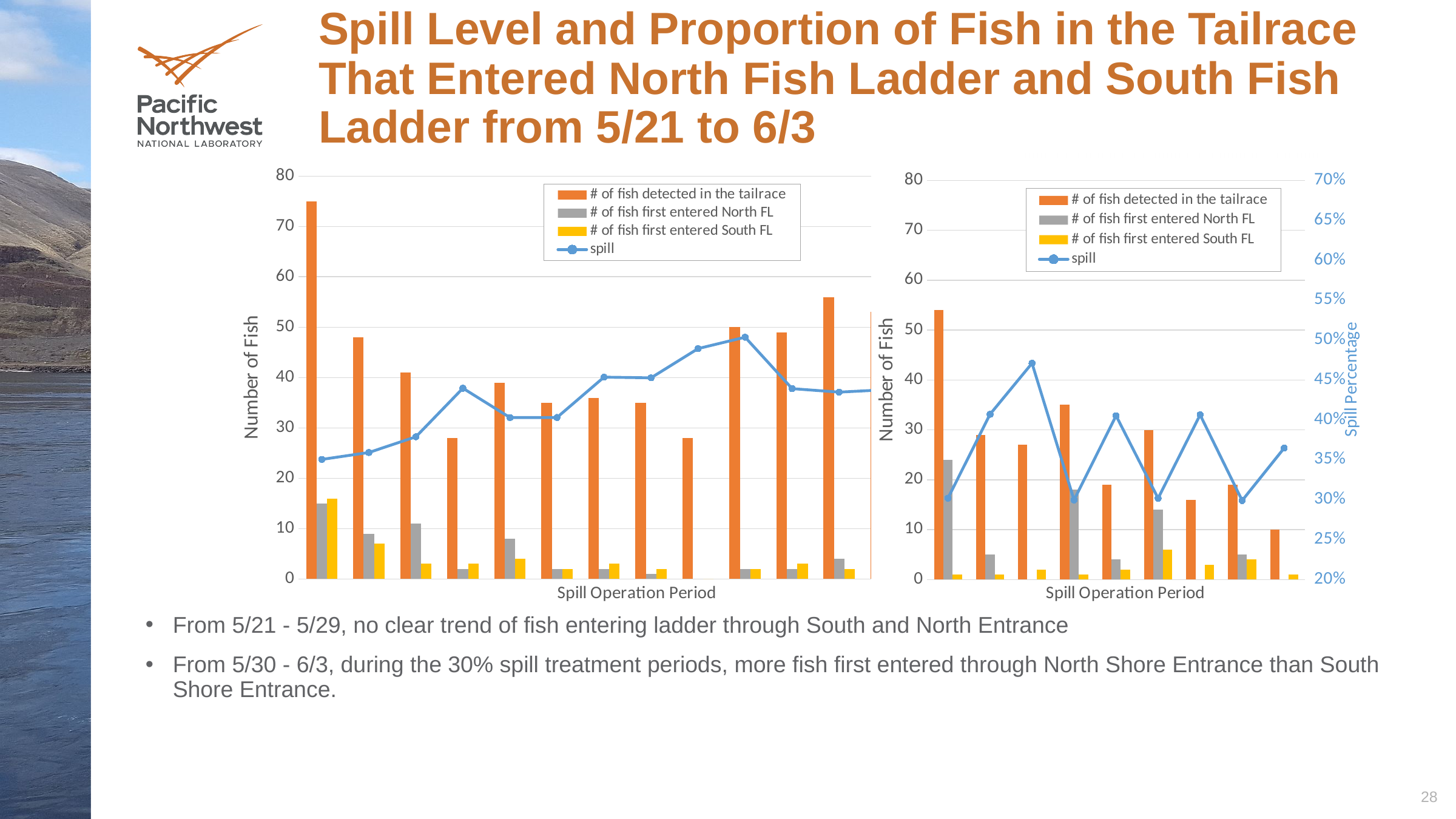
What is the x-axis title of the left chart? Spill Operation Period On the left chart, is the value of '# of fish detected in the tailrace' for the first period greater or less than 70? greater On the left chart, how many series does the legend list? 4 On the right chart, is the value of '# of fish detected in the tailrace' for the last period greater or less than 20? less On the right chart, how many spill operation periods (bar groups) are plotted? 9 On the right chart, is the value of '# of fish detected in the tailrace' for the first period greater or less than 50? greater What kind of chart is the left chart? Bar chart with a line series What is the title of the secondary (right-hand) vertical axis on the right chart? Spill Percentage On the left chart, which is larger for the first period: '# of fish first entered North FL' or '# of fish detected in the tailrace'? # of fish detected in the tailrace On the right chart, how many series does the legend list? 4